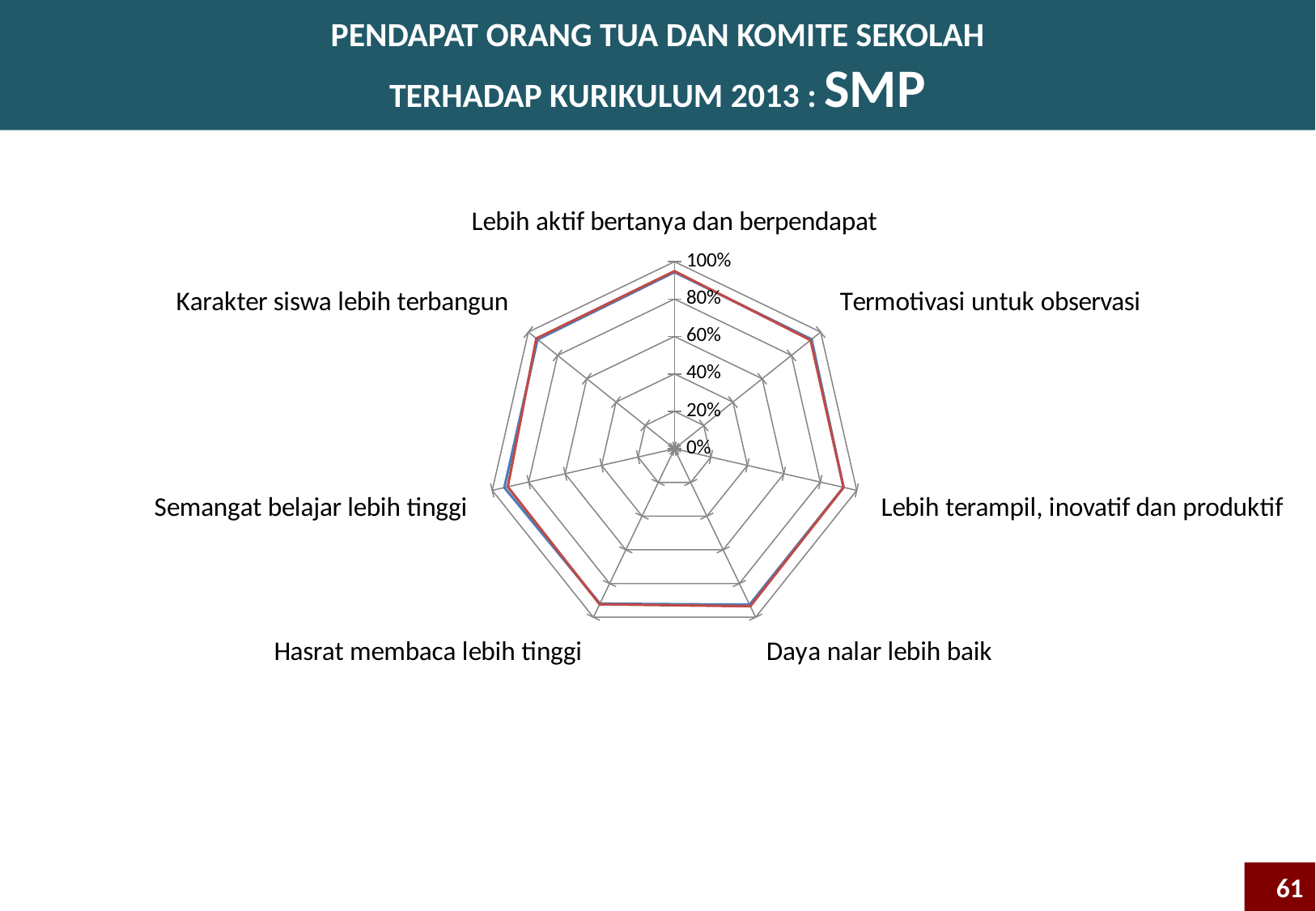
Is the value for "Lebih terampil, inovatif dan produktif" greater or less than 80%? greater Is the value for "Lebih aktif bertanya dan berpendapat" greater or less than 80%? greater What is the maximum value shown on the radar chart's axis scale? 100% Is the value for "Termotivasi untuk observasi" greater or less than 80%? greater What kind of chart is shown on the slide? Radar chart Which school level does the slide title say the chart refers to? SMP How many categories (axes) does the radar chart have? 7